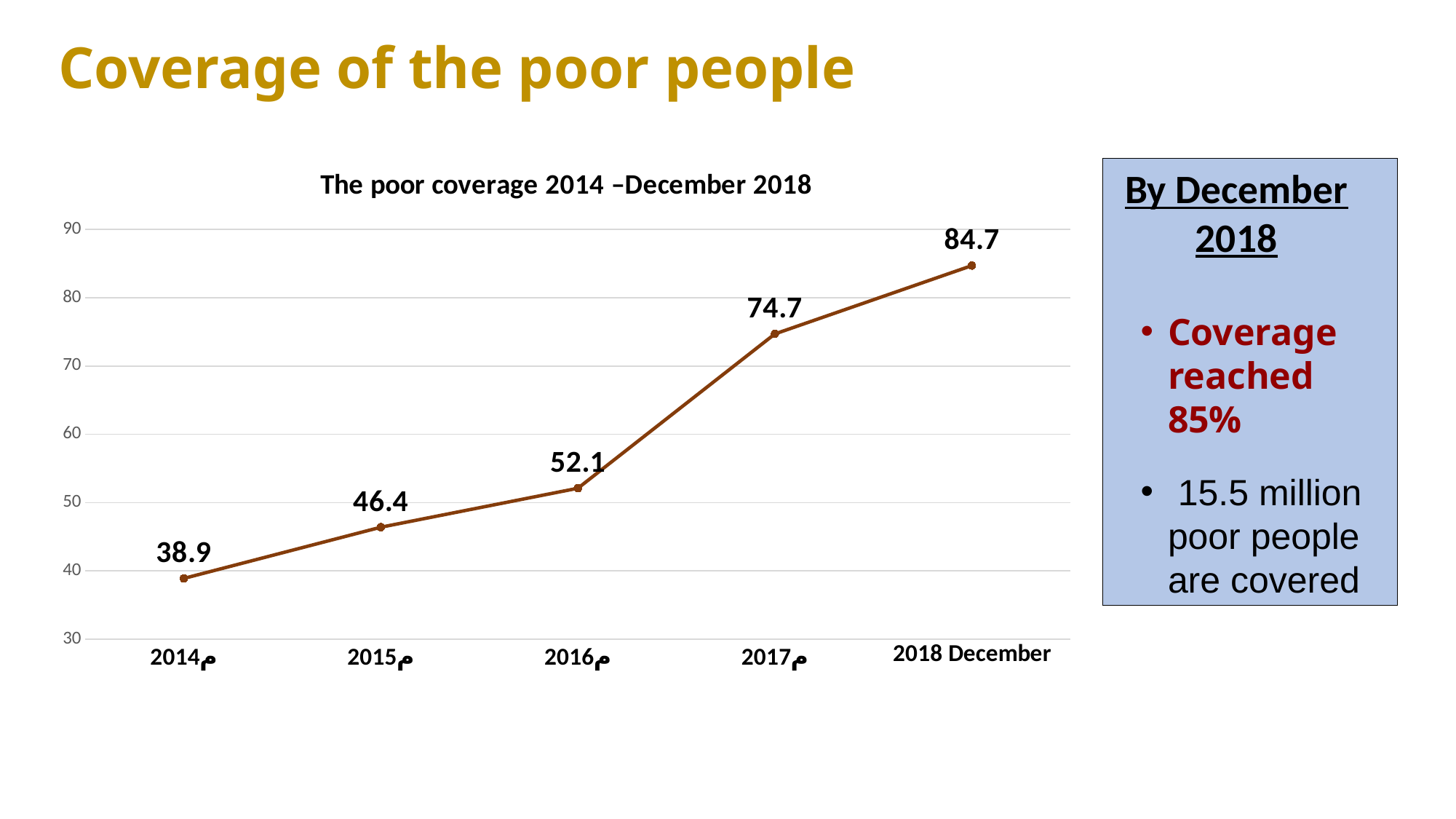
How many data points are plotted on the chart? 5 What is the poor coverage value for 2014? 38.9 What kind of chart is shown on the slide? line chart What is the poor coverage value for December 2018? 84.7 What is the difference between the coverage values for December 2018 and 2014? 45.8 Which year has the lowest poor coverage value? 2014 What is the difference between the coverage values for 2017 and 2016? 22.6 Do the coverage values rise or fall from 2014 to December 2018? rise What is the poor coverage value for 2016? 52.1 Which year has the highest poor coverage value? 2018 December Is the coverage value for 2015 greater or less than 50? less Which is larger, the coverage value for 2015 or for 2017? 2017